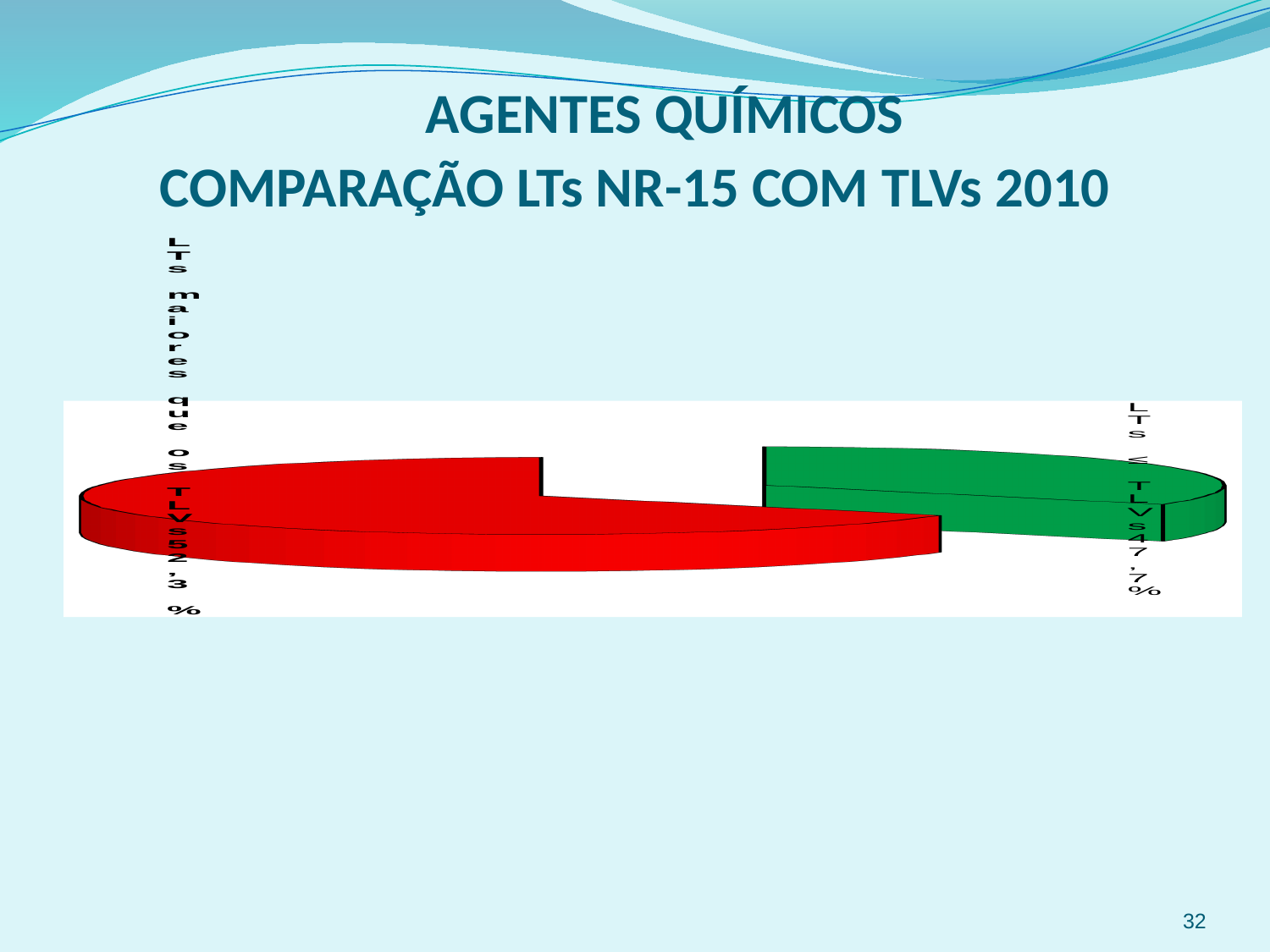
Which slice of the pie chart is the smallest? LTs ≤ TLVs Which slice of the pie chart is the largest? LTs maiores que os TLVs Is the share for "LTs maiores que os TLVs" greater or less than 50%? greater What colour is the "LTs ≤ TLVs" slice? green What kind of chart is shown on the slide? pie chart What share of the pie is labelled "LTs maiores que os TLVs"? 52,3% What share of the pie is labelled "LTs ≤ TLVs"? 47,7% Which is larger, the share for "LTs maiores que os TLVs" or the share for "LTs ≤ TLVs"? LTs maiores que os TLVs What colour is the "LTs maiores que os TLVs" slice? red How many slices does the pie chart have? 2 What is the difference in percentage points between the "LTs maiores que os TLVs" slice and the "LTs ≤ TLVs" slice? 4,6